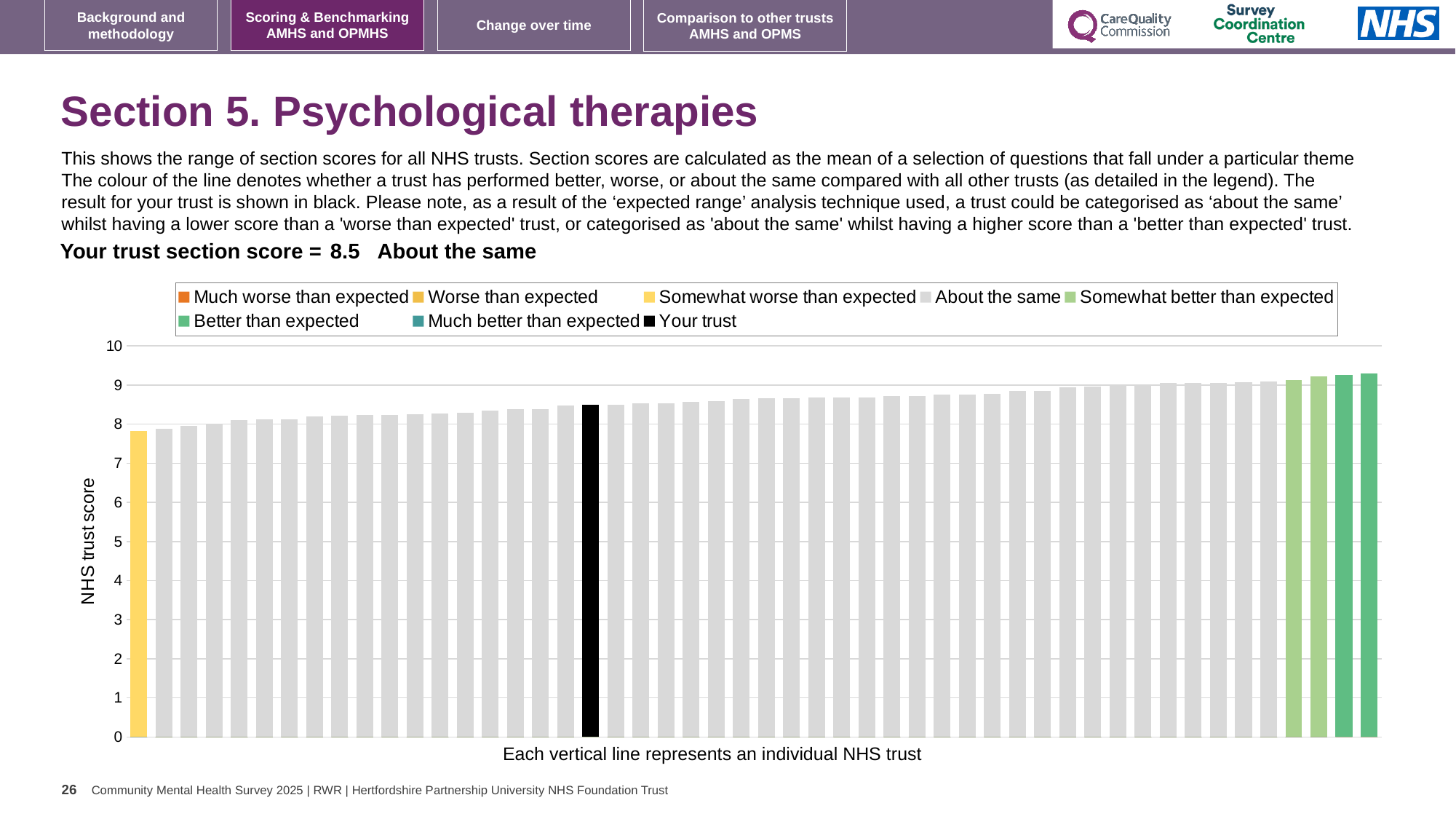
Is the value of the rightmost bar greater or less than 9? greater What kind of chart is shown on the slide? bar chart How many entries does the chart legend list? 8 Which is larger: the 'Your trust' bar or the leftmost yellow bar? Your trust Is the value of the black 'Your trust' bar greater or less than 8? greater What category does the slide assign to your trust's section score? About the same Do the bar values rise or fall from left to right along the x axis? rise What is the section score for your trust shown on the slide? 8.5 Is the value of the leftmost (yellow) bar greater or less than 7? greater What is the label on the y axis of the chart? NHS trust score How many bars are coloured yellow (Somewhat worse than expected)? 1